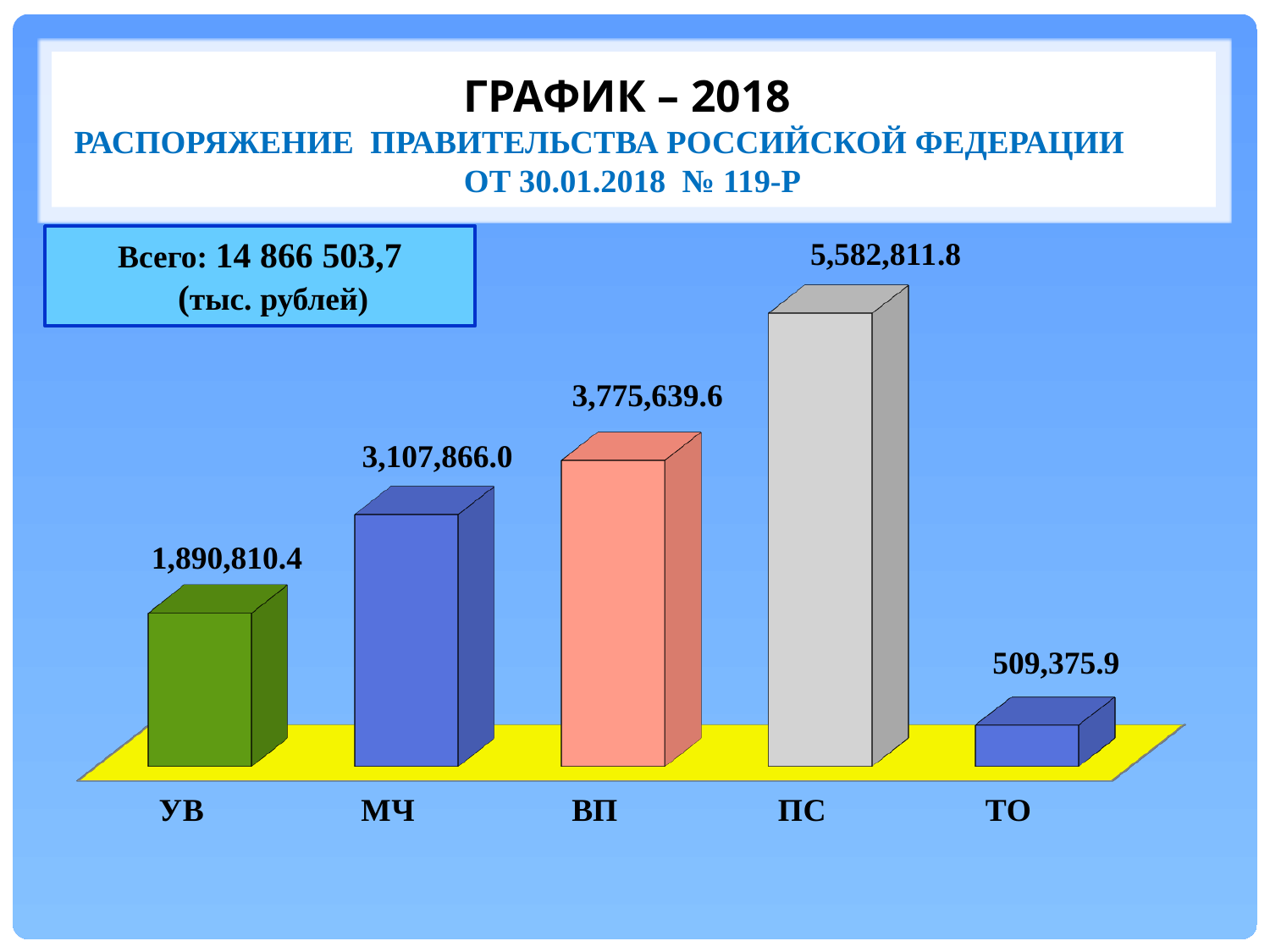
How many categories are shown in the chart? 5 What total (Всего) is stated in the box on the slide? 14 866 503,7 (тыс. рублей) Which category has the highest value? ПС What is the difference between the values for ВП and МЧ? 667,773.6 What is the difference between the values for ПС and ВП? 1,807,172.2 What is the value for ПС? 5,582,811.8 What is the value for УВ? 1,890,810.4 What is the value for МЧ? 3,107,866.0 What is the value for ТО? 509,375.9 What kind of chart is shown on the slide? Bar chart Which category has the lowest value? ТО Which is larger, the value for МЧ or the value for УВ? МЧ